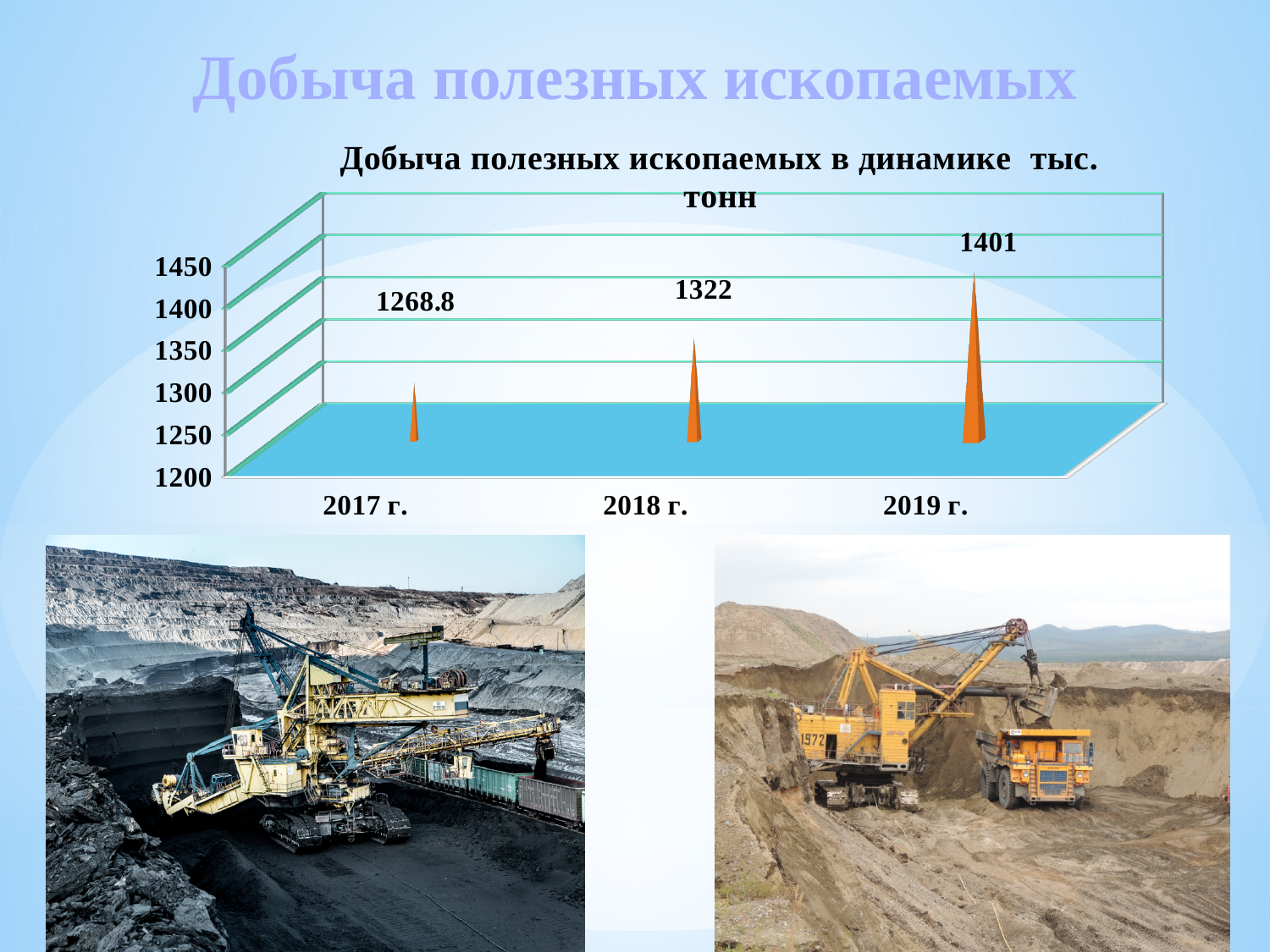
Is the value for 2019 г. greater or less than 1350? greater What is the title of the chart? Добыча полезных ископаемых в динамике тыс. тонн What is the value for 2019 г.? 1401 Which year has the highest value? 2019 г. How many years are shown on the x axis? 3 What is the value for 2017 г.? 1268.8 Do the values rise or fall from 2017 г. to 2019 г.? rise Which is larger, the value for 2017 г. or the value for 2019 г.? 2019 г. What is the difference between the values for 2019 г. and 2018 г.? 79 What is the difference between the values for 2018 г. and 2017 г.? 53.2 Which year has the lowest value? 2017 г. What is the value for 2018 г.? 1322